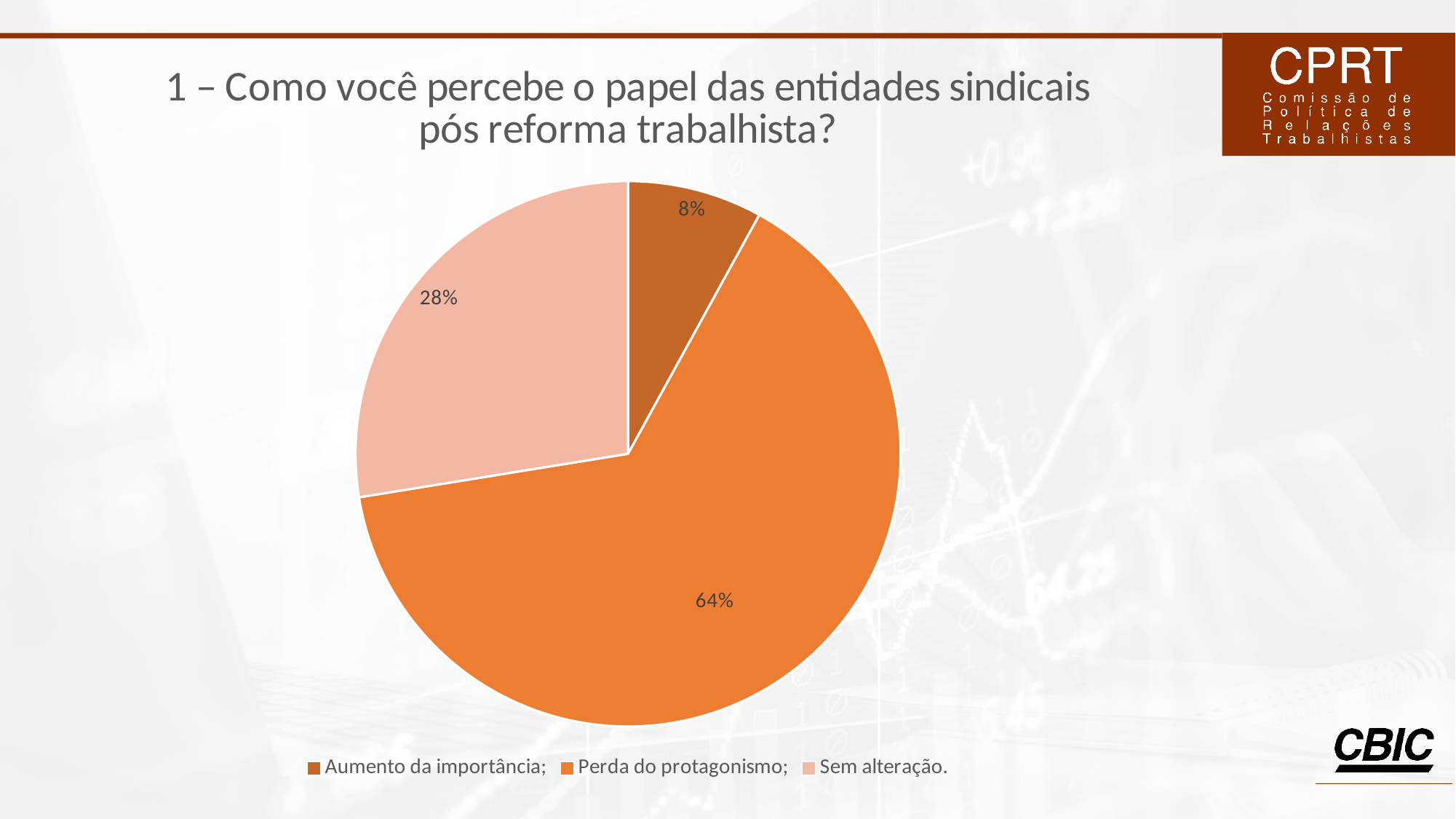
Which category has the smallest slice of the pie? Aumento da importância What is the difference in percentage points between "Sem alteração" and "Aumento da importância"? 20 Which is larger, the slice for "Sem alteração" or the slice for "Aumento da importância"? Sem alteração How many entries does the legend list? 3 What share of the pie is labelled "Sem alteração"? 28% Which category has the largest slice of the pie? Perda do protagonismo What kind of chart is shown on the slide? pie chart What is the title of the chart on the slide? 1 – Como você percebe o papel das entidades sindicais pós reforma trabalhista? How many slices does the pie chart have? 3 What share of the pie is labelled "Aumento da importância"? 8% What share of the pie is labelled "Perda do protagonismo"? 64% What is the difference in percentage points between "Perda do protagonismo" and "Sem alteração"? 36